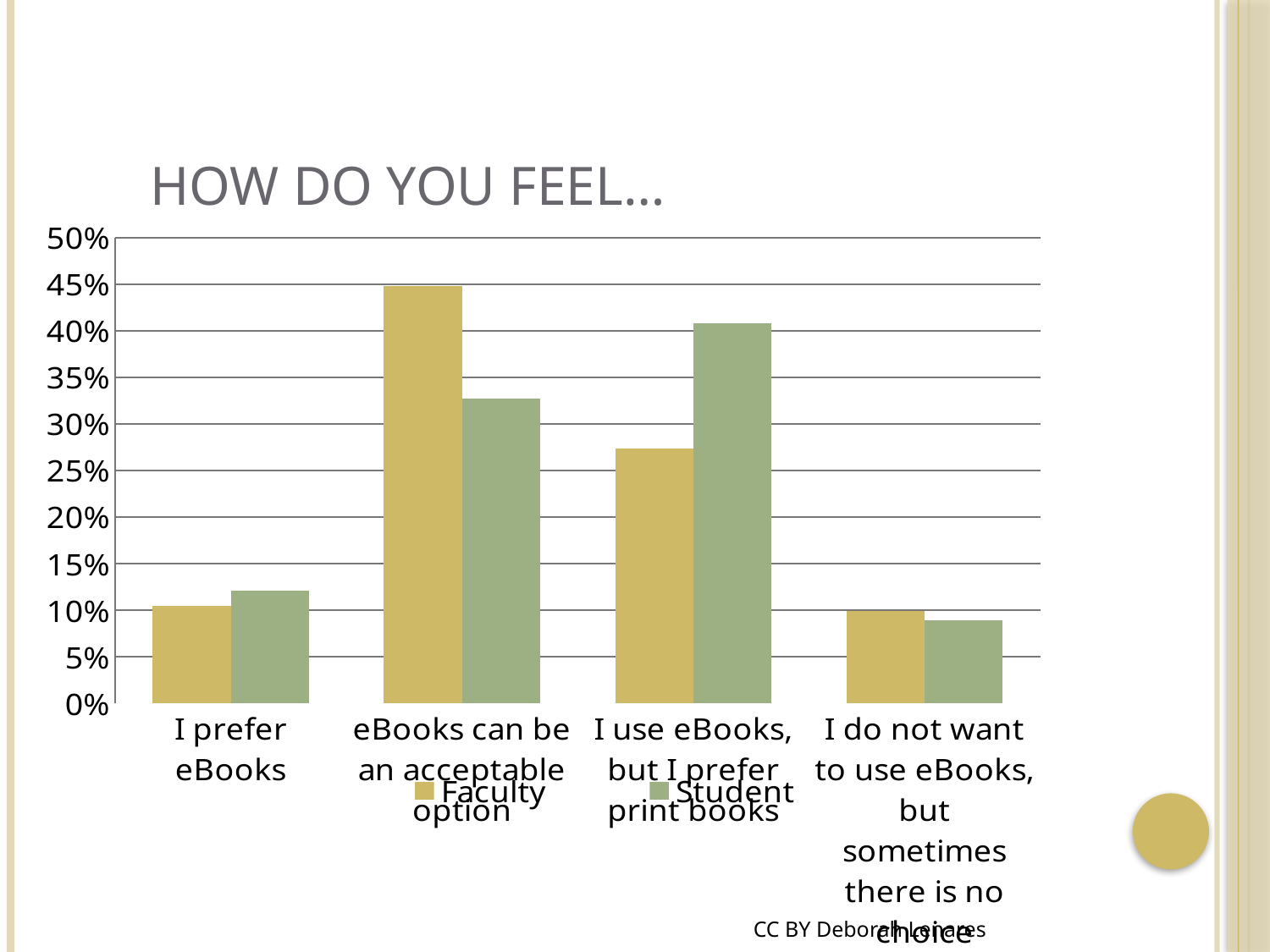
How many series does the legend list? 2 Is the Faculty value for 'eBooks can be an acceptable option' greater or less than 40%? greater Which category has the lowest Student value? I do not want to use eBooks, but sometimes there is no choice How many categories are shown on the x axis? 4 Which category has the highest Student value? I use eBooks, but I prefer print books What kind of chart is shown on the slide? bar chart Is the Student value for 'I use eBooks, but I prefer print books' greater or less than 35%? greater Is the Faculty value for 'I use eBooks, but I prefer print books' greater or less than 30%? less For 'eBooks can be an acceptable option', which is larger, the Faculty value or the Student value? Faculty Which category has the highest Faculty value? eBooks can be an acceptable option What is the title of the slide containing the chart? HOW DO YOU FEEL... For 'I use eBooks, but I prefer print books', which is larger, the Faculty value or the Student value? Student